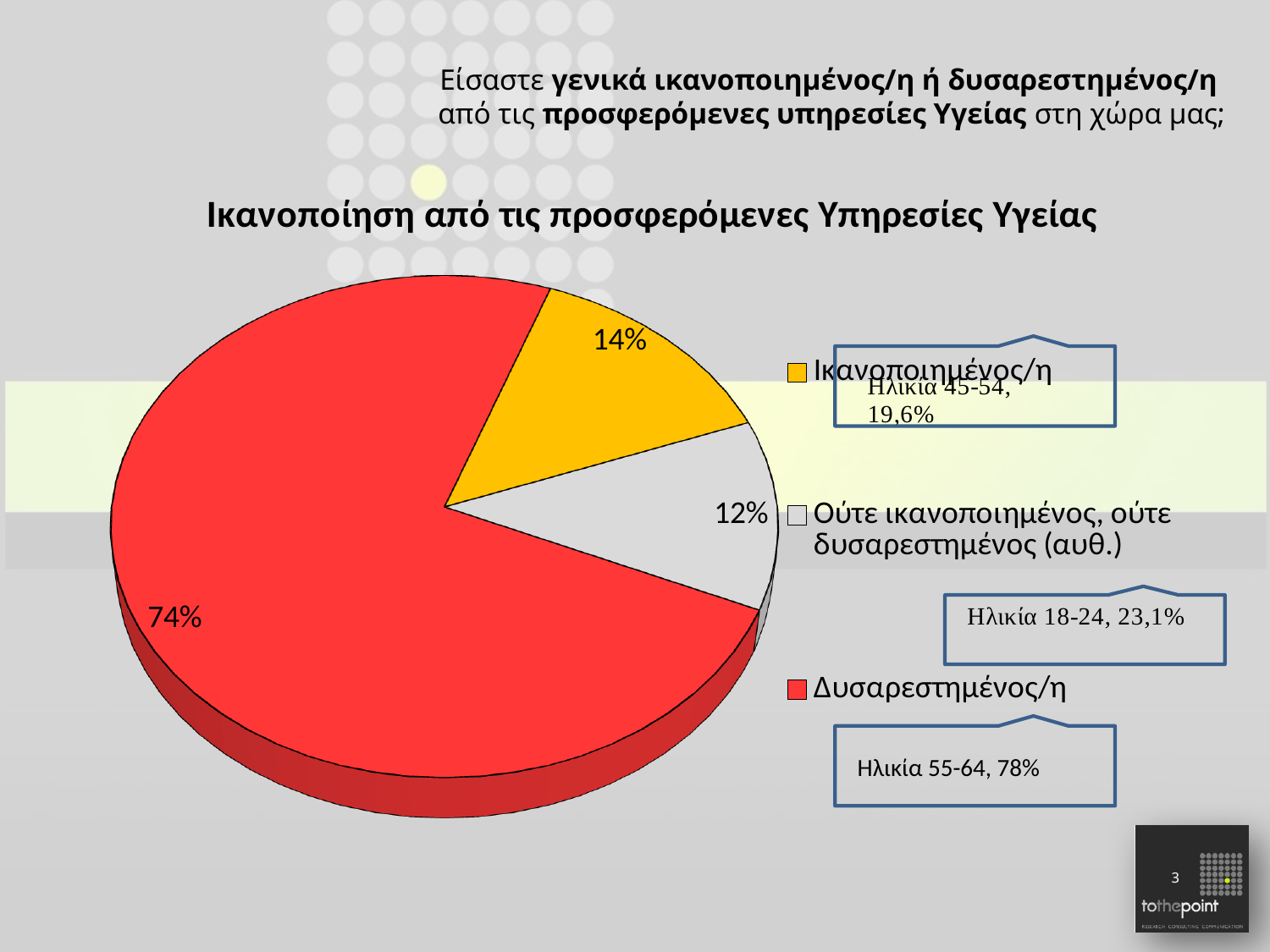
Which slice of the pie is the smallest? Ούτε ικανοποιημένος, ούτε δυσαρεστημένος (αυθ.) Which slice of the pie is the largest? Δυσαρεστημένος/η Which is larger, the Ικανοποιημένος/η slice or the Ούτε ικανοποιημένος, ούτε δυσαρεστημένος (αυθ.) slice? Ικανοποιημένος/η What colour is the Δυσαρεστημένος/η slice in the pie chart? red What percentage of the pie is labelled Ικανοποιημένος/η? 14% What is the title of the chart? Ικανοποίηση από τις προσφερόμενες Υπηρεσίες Υγείας What percentage of the pie is labelled Ούτε ικανοποιημένος, ούτε δυσαρεστημένος (αυθ.)? 12% What is the difference in percentage points between the Δυσαρεστημένος/η slice and the Ικανοποιημένος/η slice? 60 What percentage of the pie is labelled Δυσαρεστημένος/η? 74% What type of chart is shown on the slide? pie chart How many slices does the pie chart have? 3 According to the callout attached to the Δυσαρεστημένος/η legend entry, what is the value for Ηλικία 55-64? 78%